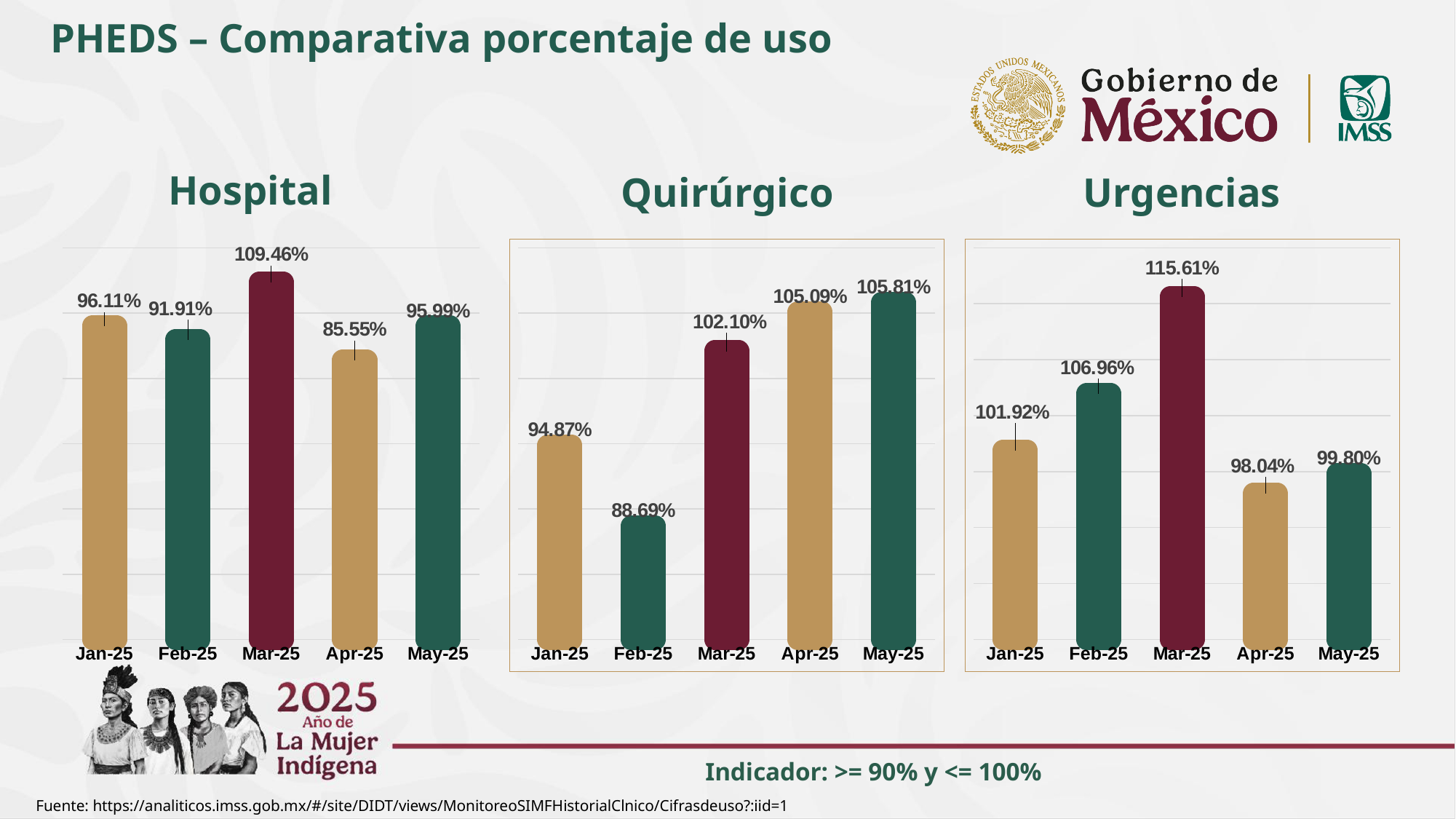
In the Urgencias chart, what is the value for Apr-25? 98.04% In the Quirúrgico chart, what is the value for Feb-25? 88.69% In the Quirúrgico chart, which is larger, the value for Jan-25 or the value for Mar-25? Mar-25 How many months are shown in the Urgencias chart? 5 In the Urgencias chart, what is the difference between the Mar-25 and Feb-25 values? 8.65% In the Hospital chart, what is the value for Mar-25? 109.46% In the Urgencias chart, which month has the highest value? Mar-25 What kind of chart is the Hospital chart? Bar chart In the Hospital chart, what is the difference between the Mar-25 and Apr-25 values? 23.91% In the Quirúrgico chart, which month has the lowest value? Feb-25 In the Hospital chart, which month has the lowest value? Apr-25 How many charts are shown on the slide? 3